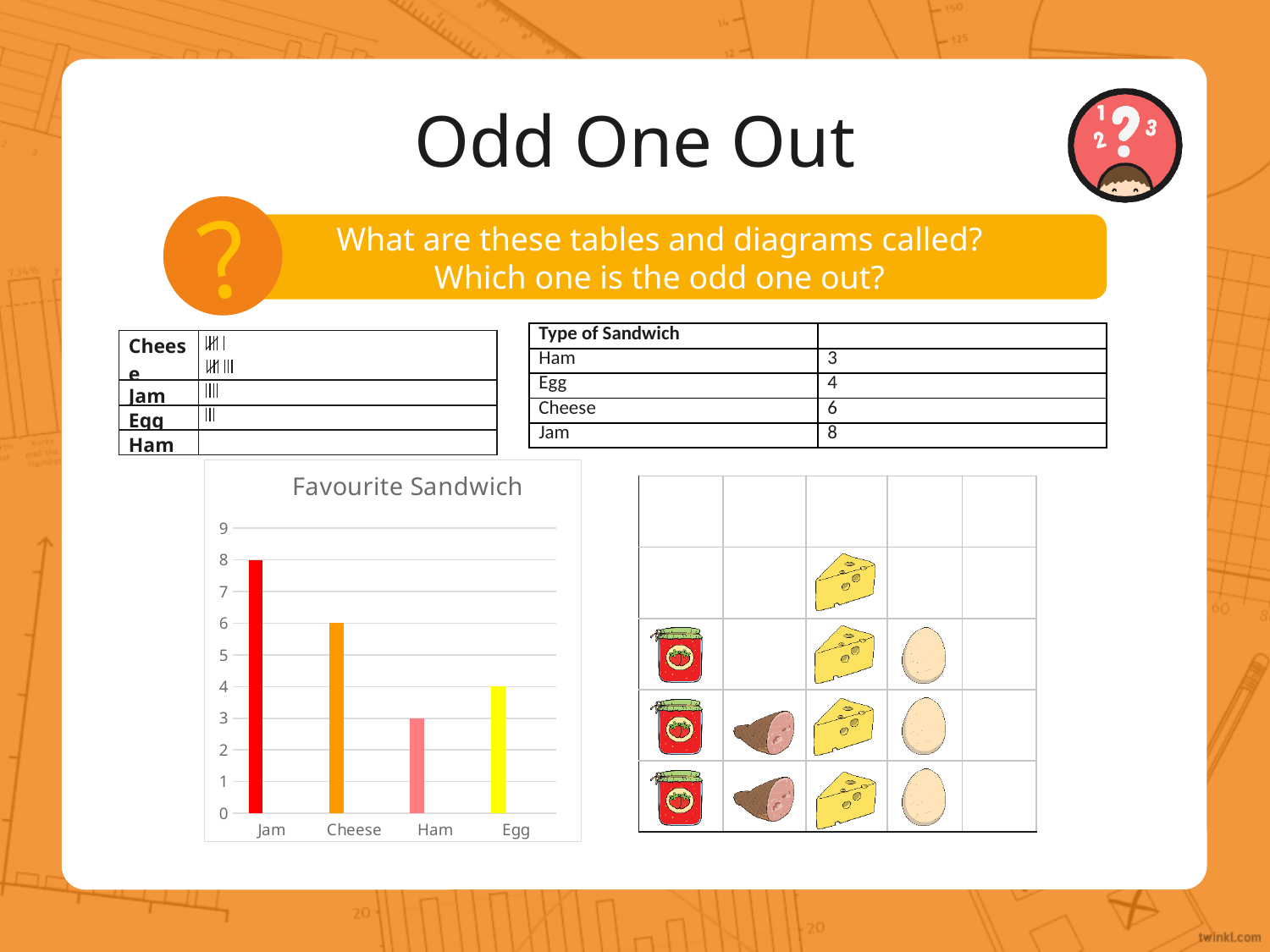
In the Favourite Sandwich bar chart, is the value for Jam greater or less than 5? greater What kind of chart is the Favourite Sandwich chart? bar chart In the Favourite Sandwich bar chart, what is the difference between the values for Jam and Ham? 5 In the Favourite Sandwich bar chart, which sandwich has the highest value? Jam In the Favourite Sandwich bar chart, which sandwich has the lowest value? Ham In the Favourite Sandwich bar chart, what is the value for Jam? 8 In the Favourite Sandwich bar chart, what is the value for Ham? 3 In the Favourite Sandwich bar chart, which is larger, the value for Cheese or the value for Egg? Cheese How many categories are shown on the x axis of the Favourite Sandwich bar chart? 4 What is the title of the bar chart on the slide? Favourite Sandwich In the Favourite Sandwich bar chart, what is the value for Egg? 4 In the Favourite Sandwich bar chart, what is the value for Cheese? 6